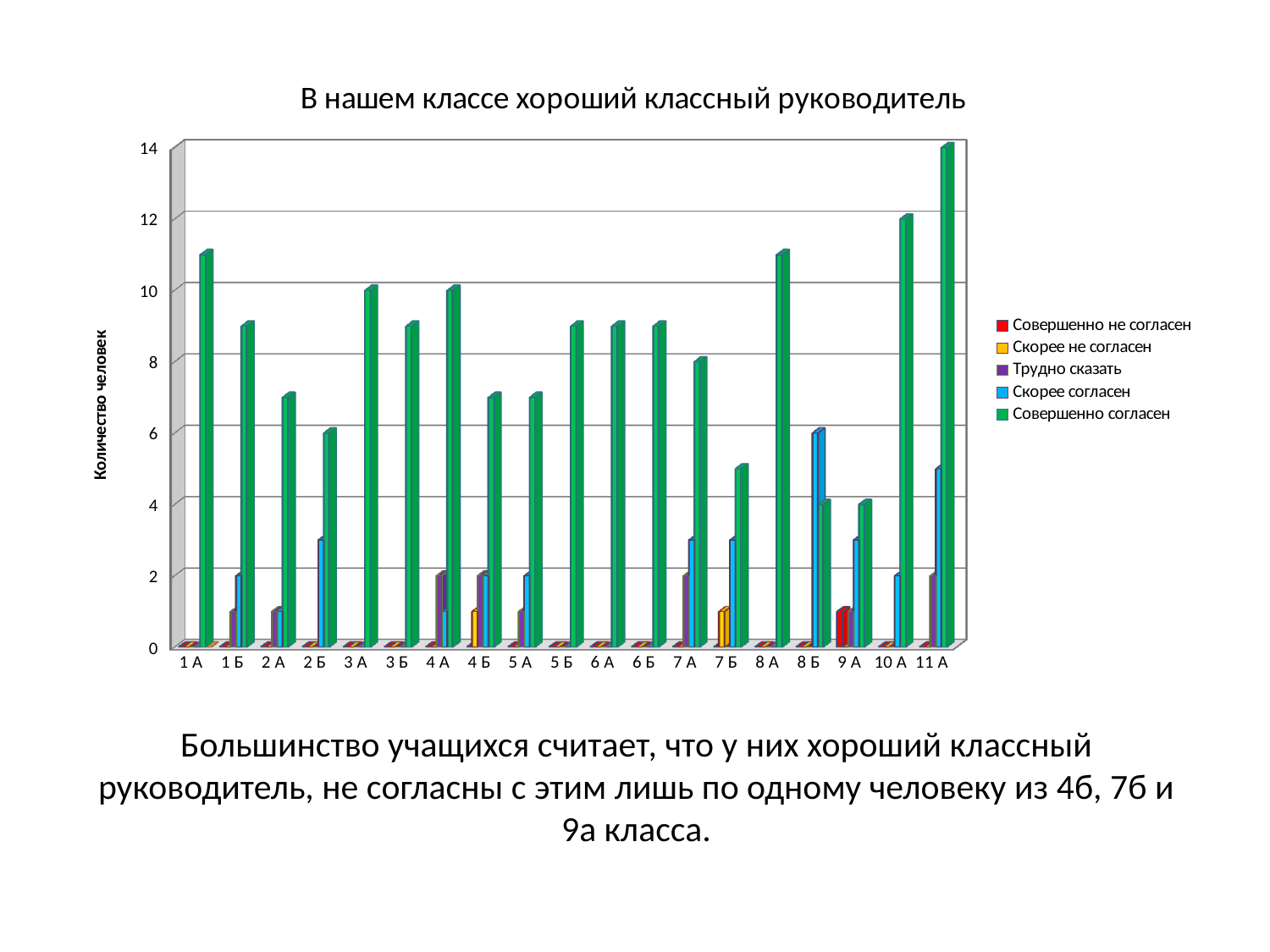
Is the value for 'Совершенно согласен' in class 7 Б greater or less than 6? less Which class has the highest value for 'Совершенно согласен'? 11 А Is the value for 'Совершенно согласен' in class 1 А greater or less than 10? greater What kind of chart is shown on the slide? bar chart What is the value for 'Совершенно согласен' in class 10 А? 12 What is the value for 'Скорее согласен' in class 8 Б? 6 How many series does the legend list? 5 What is the value for 'Совершенно согласен' in class 11 А? 14 What is the label of the vertical axis? Количество человек What is the title of the chart? В нашем классе хороший классный руководитель How many classes are shown along the x axis? 19 In class 8 Б, which is larger: 'Скорее согласен' or 'Совершенно согласен'? Скорее согласен